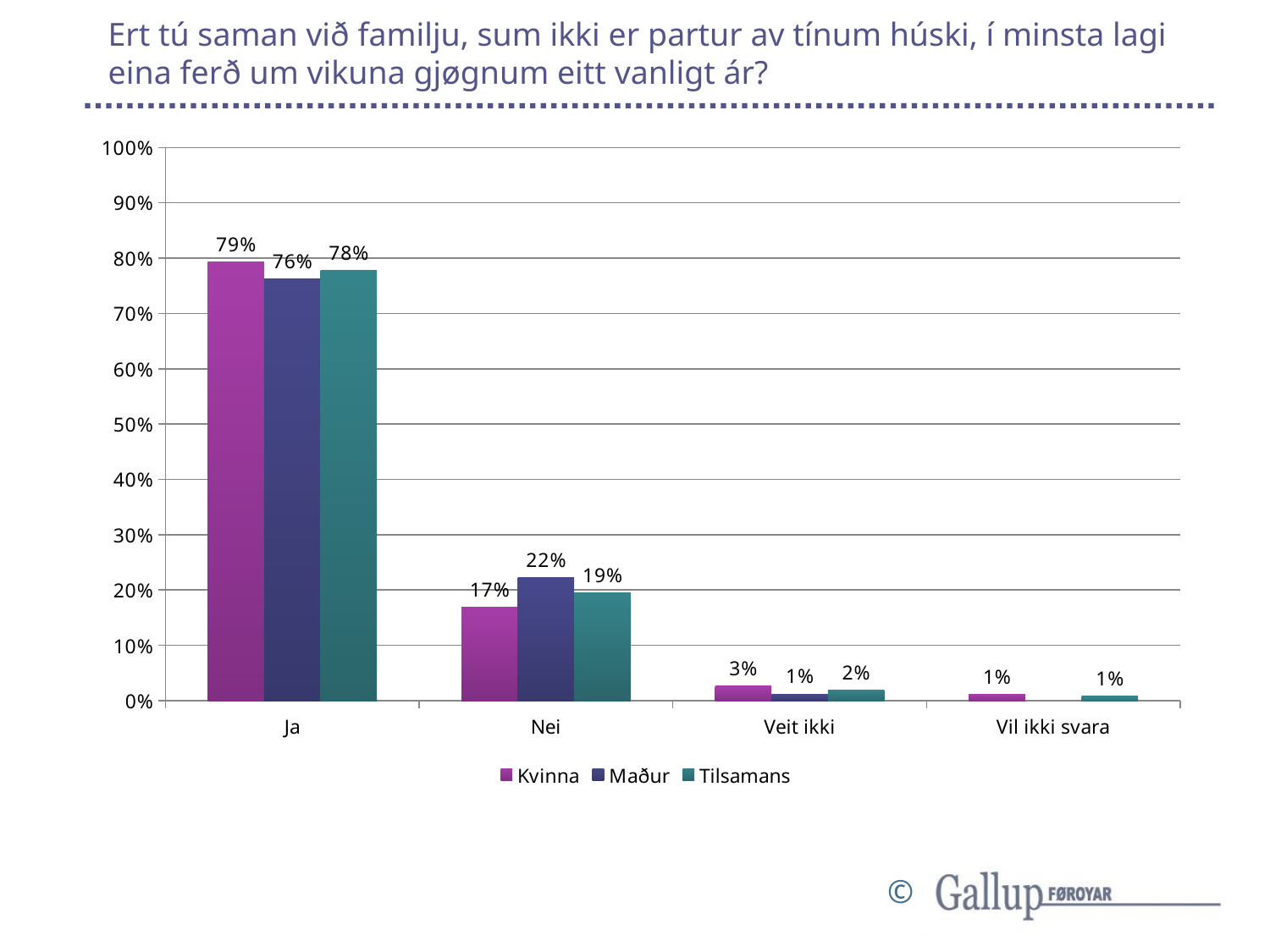
What is the difference between the Maður and Kvinna values in the Nei category? 5% Which category has the lowest value for the Kvinna series? Vil ikki svara How many series does the legend list? 3 Which category has the highest value for the Tilsamans series? Ja What is the value for Tilsamans in the Veit ikki category? 2% What is the value for Maður in the Nei category? 22% How many categories are shown on the x axis? 4 In the Nei category, which is larger: the Kvinna value or the Maður value? Maður What is the value for Kvinna in the Ja category? 79% What kind of chart is shown on the slide? Bar chart Is the value for Tilsamans in the Ja category greater or less than 70%? greater What is the difference between the Kvinna and Maður values in the Ja category? 3%